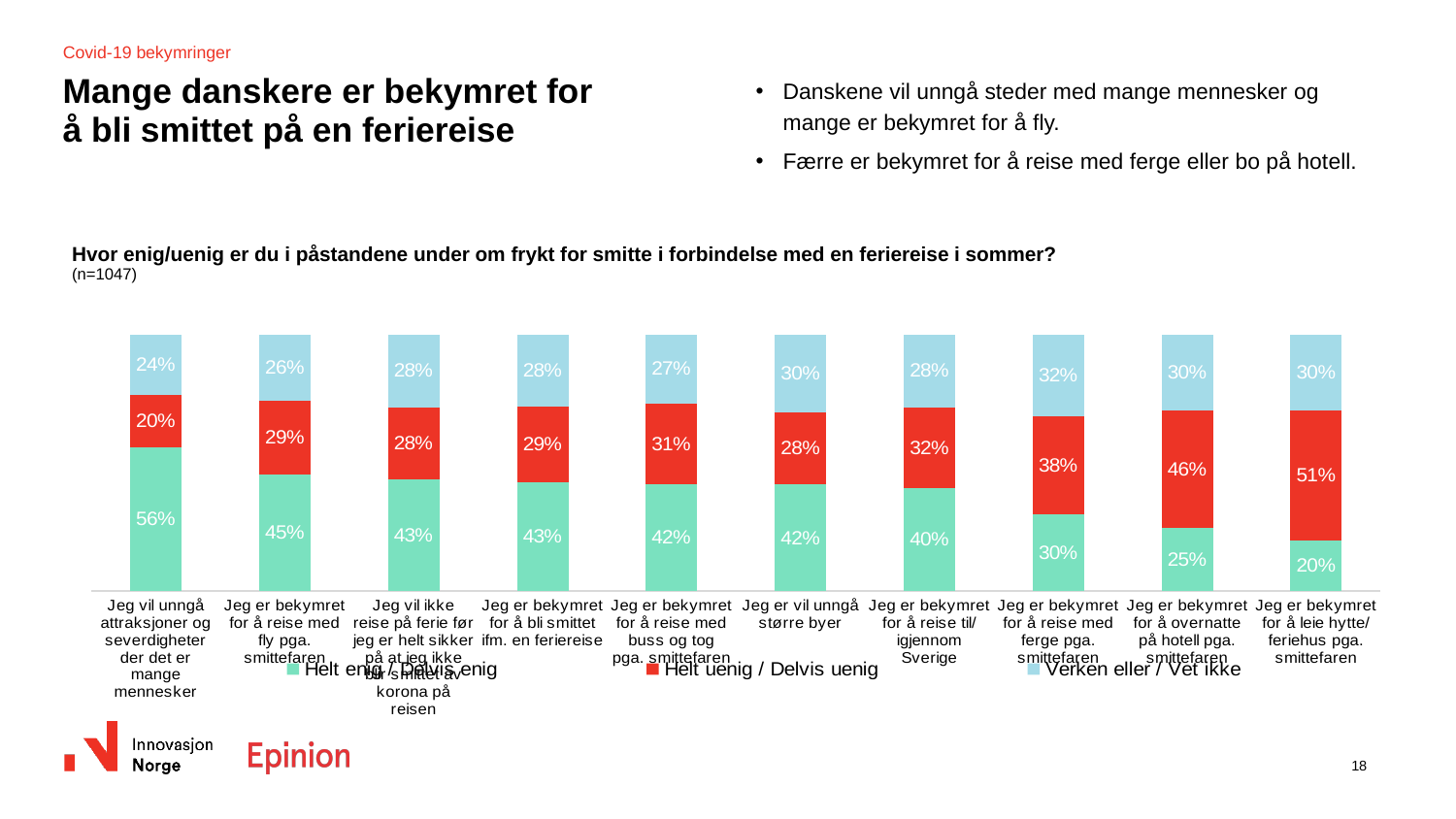
Which colour represents 'Helt uenig / Delvis uenig' in the chart? Red What type of chart is shown on the slide? Stacked bar chart What is the difference between the 'Helt enig / Delvis enig' values for 'Jeg er bekymret for å reise med fly pga. smittefaren' and 'Jeg er bekymret for å overnatte på hotell pga. smittefaren'? 20 percentage points What is the 'Verken eller / Vet ikke' value for 'Jeg er bekymret for å reise med ferge pga. smittefaren'? 32% Which statement has the highest 'Helt enig / Delvis enig' share? Jeg vil unngå attraksjoner og severdigheter der det er mange mennesker What is the 'Helt uenig / Delvis uenig' value for 'Jeg er bekymret for å leie hytte/feriehus pga. smittefaren'? 51% Which is larger: the 'Helt uenig / Delvis uenig' value for 'Jeg er bekymret for å reise med ferge pga. smittefaren' or for 'Jeg er bekymret for å reise til/igjennom Sverige'? Jeg er bekymret for å reise med ferge pga. smittefaren How many categories (statements) are shown on the x axis of the chart? 10 What is the 'Helt enig / Delvis enig' value for 'Jeg vil unngå attraksjoner og severdigheter der det er mange mennesker'? 56% How many series does the chart's legend list? 3 What is the total of the stacked bar for 'Jeg er bekymret for å reise med buss og tog pga. smittefaren'? 100% Which statement has the lowest 'Helt enig / Delvis enig' share? Jeg er bekymret for å leie hytte/feriehus pga. smittefaren